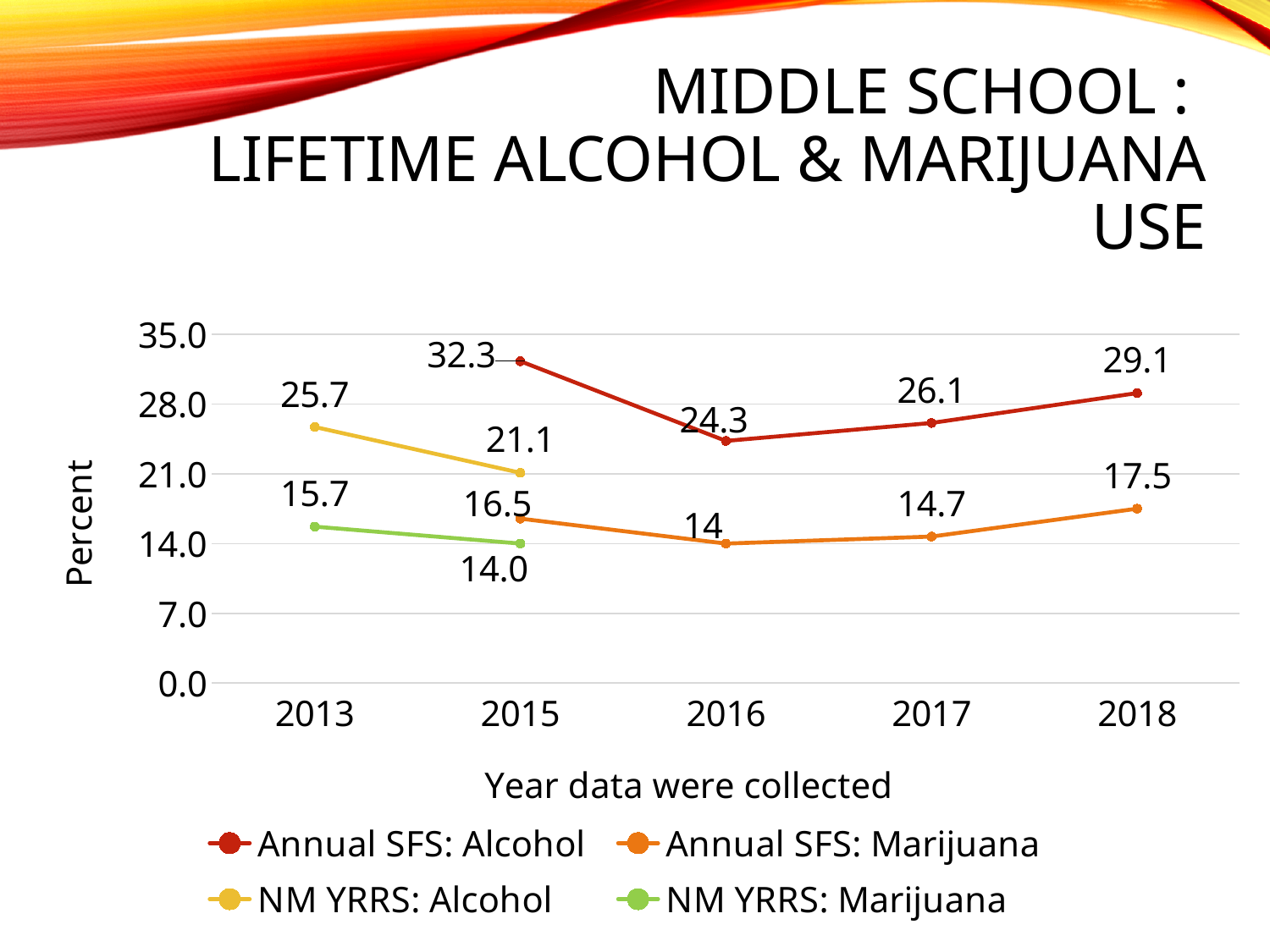
What is the value for NM YRRS: Marijuana in 2015? 14.0 What is the value for Annual SFS: Marijuana in 2018? 17.5 Does NM YRRS: Alcohol rise or fall from 2013 to 2015? fall What is the difference between Annual SFS: Alcohol in 2015 and in 2016? 8.0 Which is larger in 2015: NM YRRS: Alcohol or Annual SFS: Marijuana? NM YRRS: Alcohol In which year is Annual SFS: Alcohol at its lowest? 2016 What type of chart is shown on the slide? line chart How many years are shown on the x axis? 5 What is the value for NM YRRS: Alcohol in 2013? 25.7 How many series does the legend list? 4 In which year is Annual SFS: Marijuana at its highest? 2018 What is the value for Annual SFS: Alcohol in 2015? 32.3